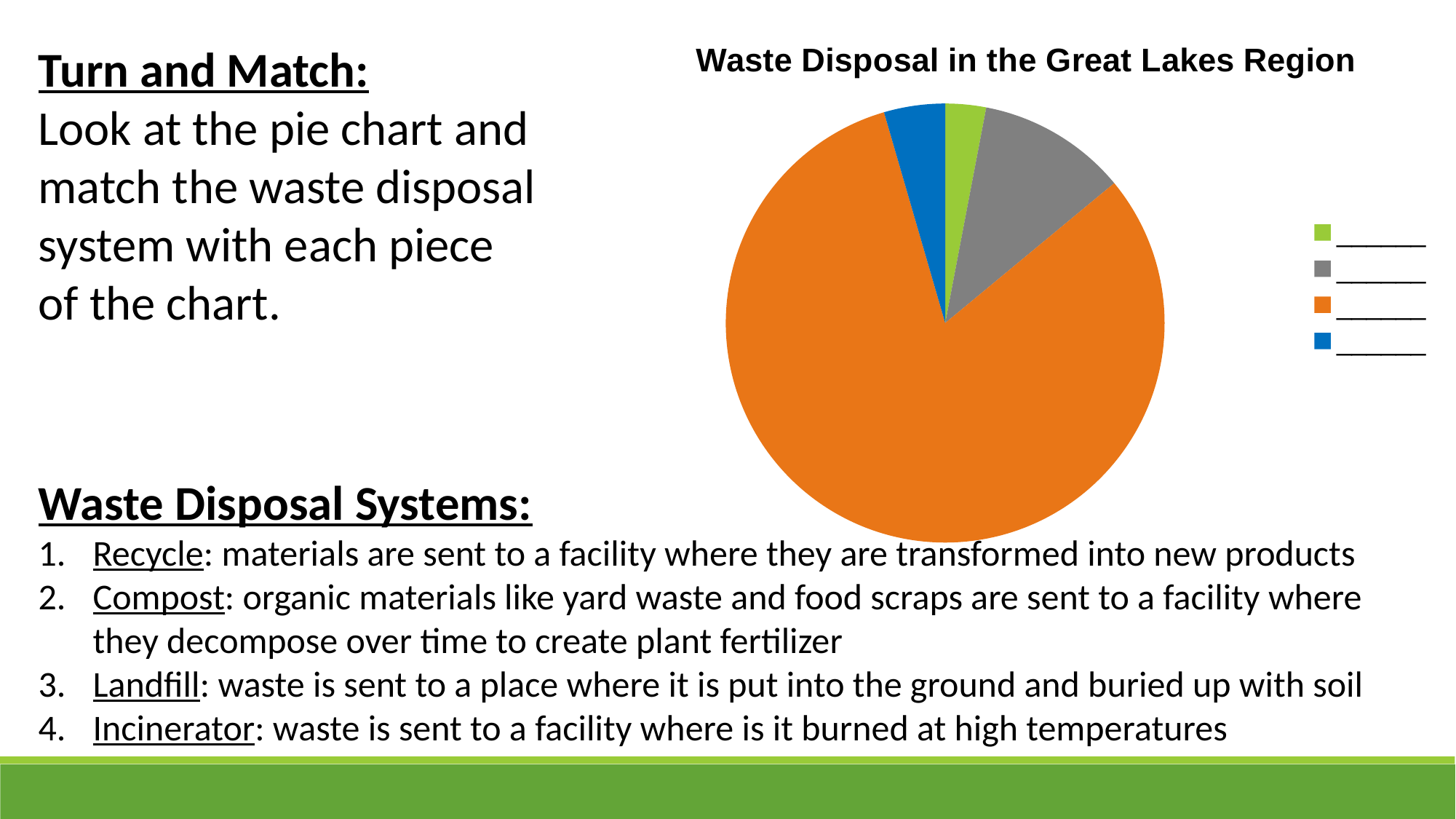
Which colour slice is the largest in the pie chart? orange Which colour slice is the smallest in the pie chart? green Does the orange slice take up more or less than half of the pie chart? more How many entries does the legend of the pie chart list? 4 Is the grey slice or the blue slice larger in the pie chart? grey How many slices does the pie chart have? 4 What kind of chart is shown on the slide? pie chart What is the title of the pie chart? Waste Disposal in the Great Lakes Region Is the orange slice or the grey slice larger in the pie chart? orange Are the legend entries of the pie chart filled in with category names? No